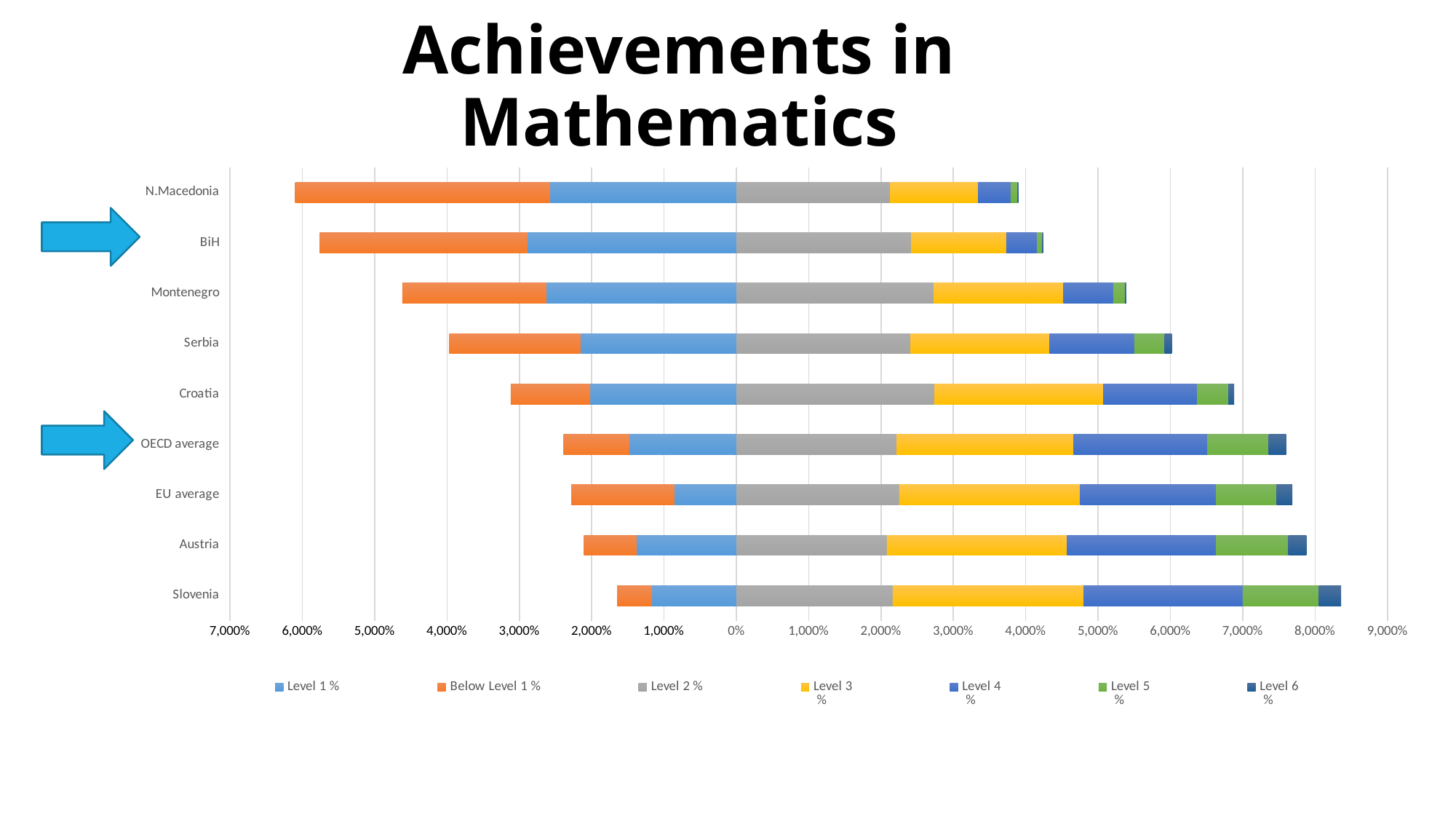
What kind of chart is shown on the slide? Stacked bar chart Which category has the largest 'Below Level 1 %' segment? N.Macedonia Which category's bar extends furthest to the left of the 0% line? N.Macedonia Which category's bar extends furthest to the right of the 0% line? Slovenia What is the title of the chart? Achievements in Mathematics Which colour represents the 'Below Level 1 %' series in the legend? Orange Which has the larger 'Level 3 %' segment, Slovenia or N.Macedonia? Slovenia How many series does the legend list? 7 Is the right-hand end of the Slovenia bar greater or less than 8,000%? greater How many categories (countries/averages) are listed on the vertical axis? 9 Is the right-hand end of the N.Macedonia bar greater or less than 4,000%? less Which category has the smallest 'Below Level 1 %' segment? Slovenia